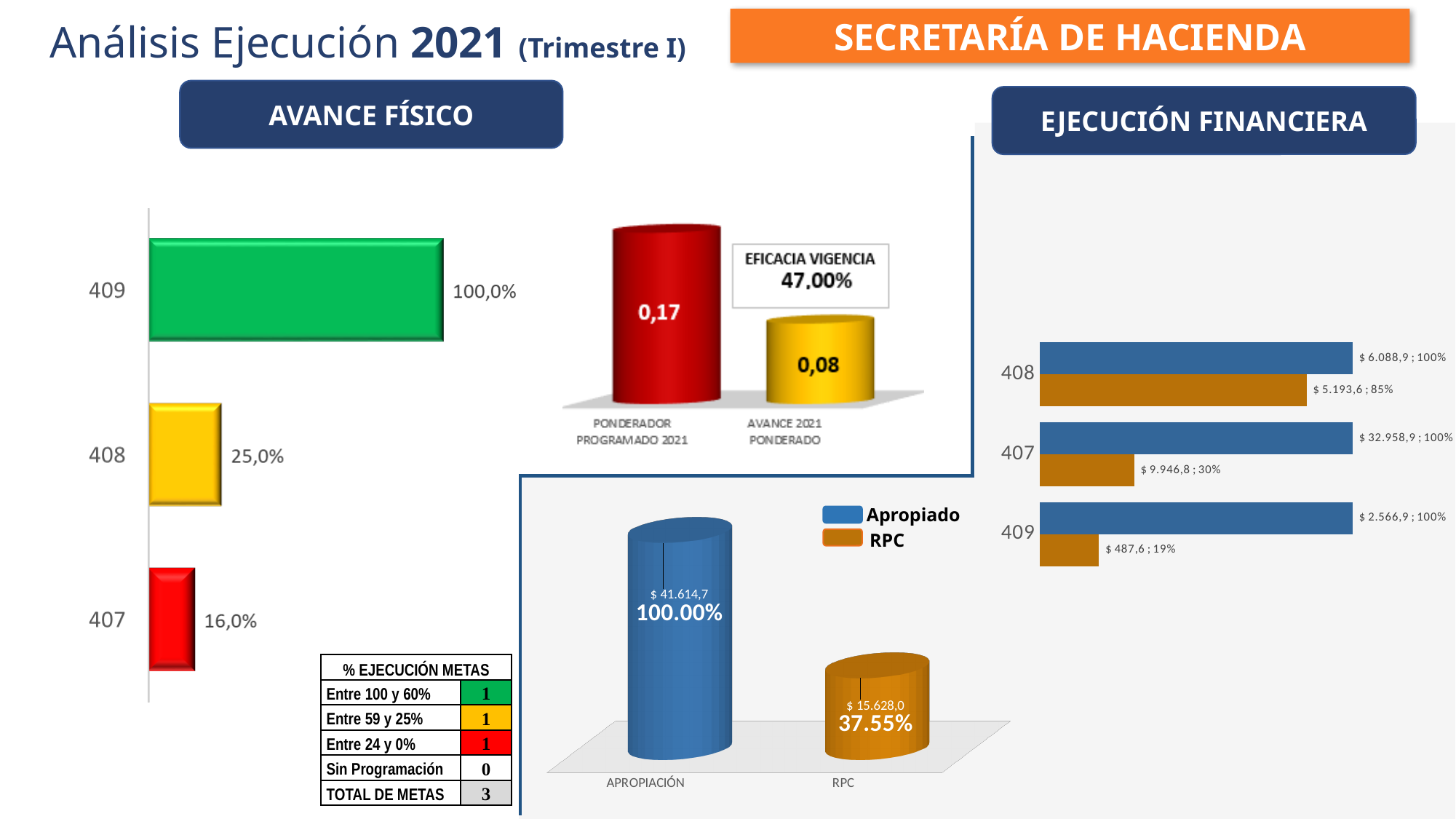
What kind of chart is the Ejecución Financiera chart on the right? Bar chart In the bottom-middle chart with Apropiación and RPC, what percentage is shown for RPC? 37.55% In the Ejecución Financiera bar chart on the right, what is the RPC value for category 407? $ 9.946,8 ; 30% In the chart with Ponderador Programado 2021 and Avance 2021 Ponderado, what Eficacia Vigencia percentage is shown? 47,00% In the Ejecución Financiera bar chart on the right, how many series does the legend list? 2 In the bottom-middle chart with Apropiación and RPC, what amount is shown for Apropiación? $ 41.614,7 In the Avance Físico bar chart on the left, what is the difference between the values for 408 and 407? 9,0% In the Ejecución Financiera bar chart on the right, which category has the highest Apropiado value? 407 In the Avance Físico bar chart on the left, which category has the lowest value? 407 In the Avance Físico bar chart on the left, what is the value for category 409? 100,0% In the chart with Ponderador Programado 2021 and Avance 2021 Ponderado, what is the value for Ponderador Programado 2021? 0,17 In the Avance Físico bar chart on the left, how many categories are plotted? 3